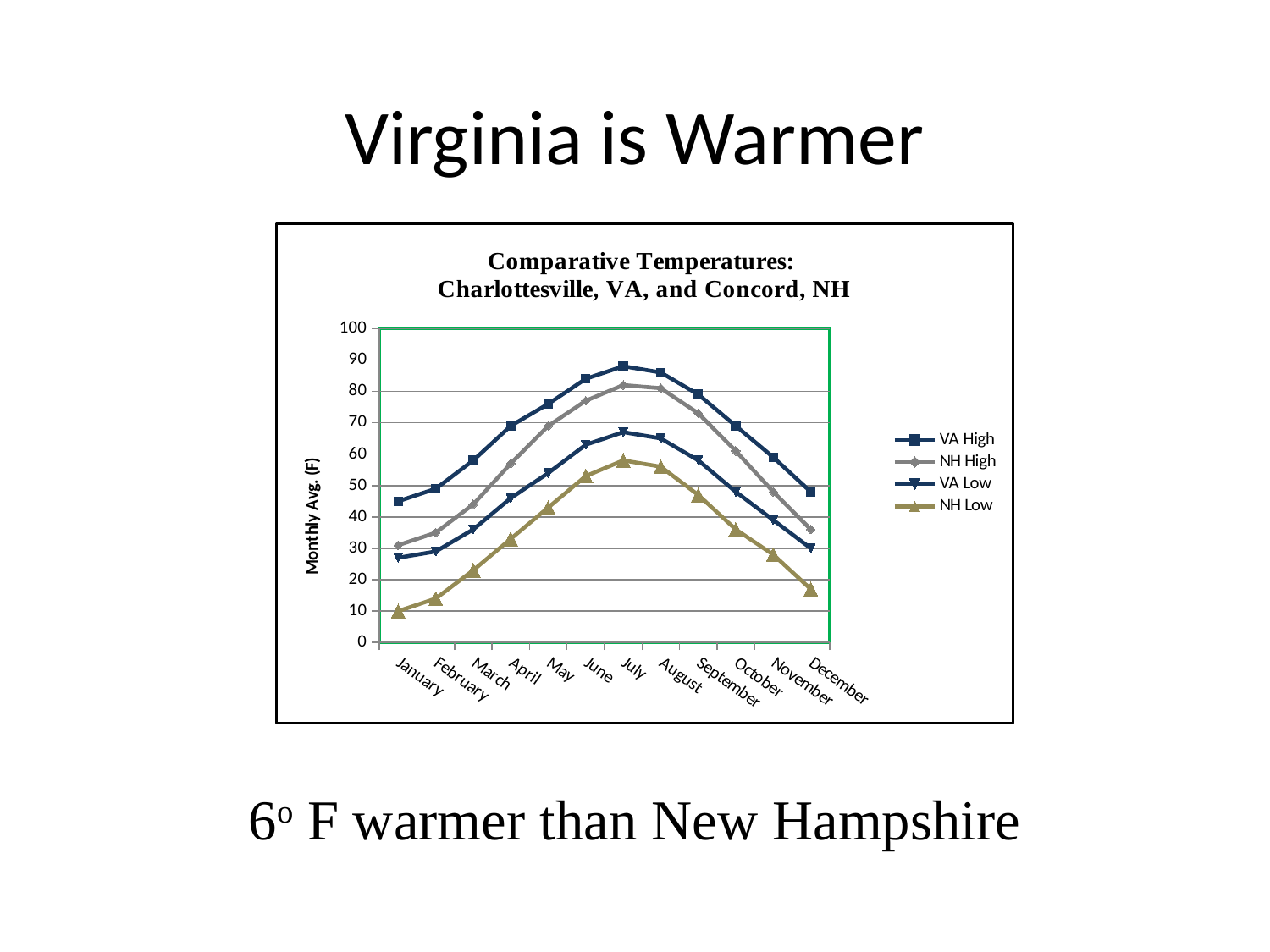
Which is higher in July, VA High or NH High? VA High How many months are plotted along the x axis? 12 Do the VA High values rise or fall from January to July? rise Is the value for NH Low in December greater or less than 20? less In which month does the VA High series reach its highest value? July What is the label on the y axis of the chart? Monthly Avg. (F) In which month is the NH Low series at its lowest value? January What kind of chart is shown on the slide? line chart Is the value for VA High in July greater or less than 80? greater Which is higher in January, VA Low or NH Low? VA Low How many series does the legend list? 4 Is the value for NH Low in July greater or less than 50? greater